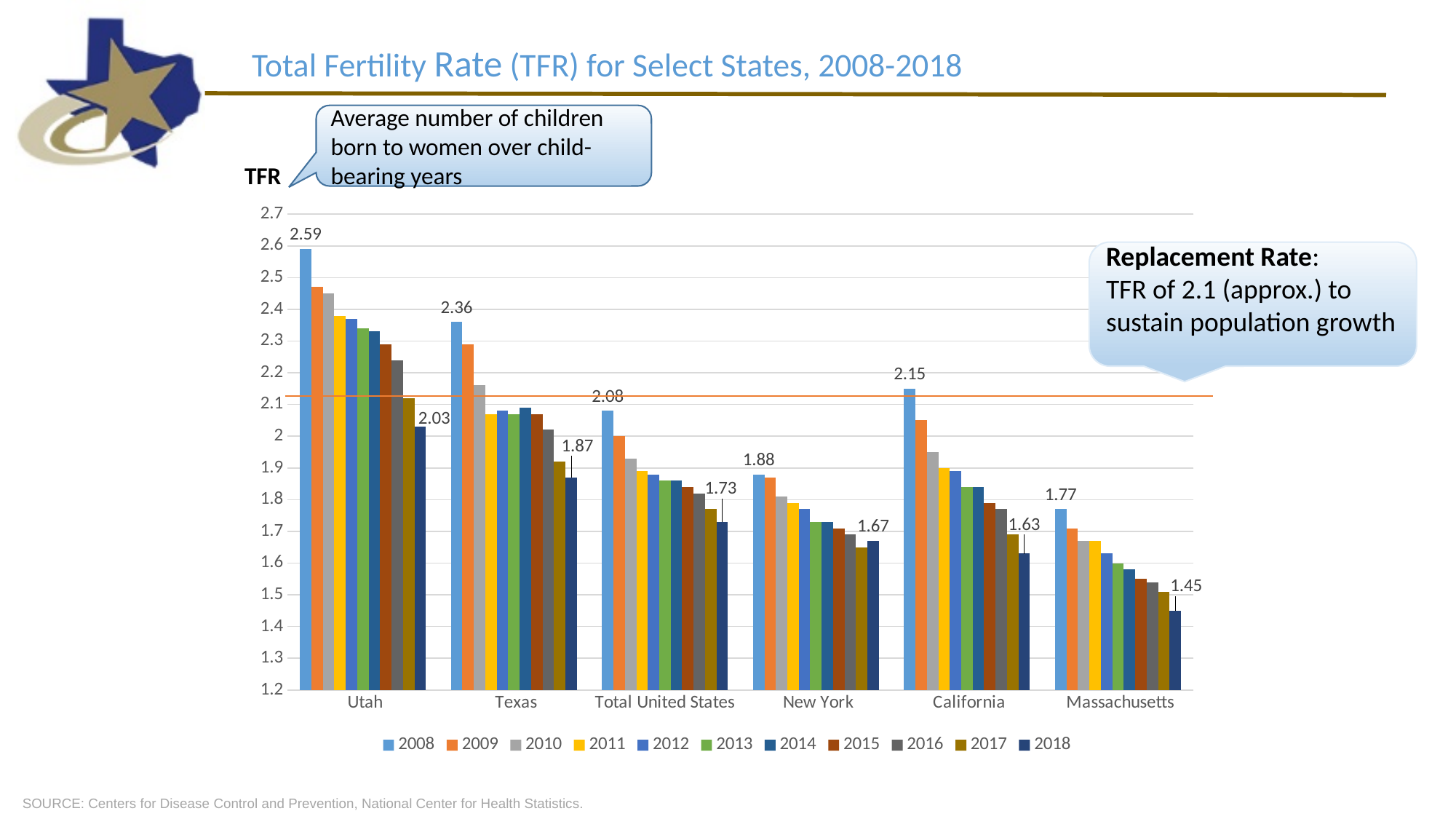
What was Texas's total fertility rate in 2018? 1.87 How many states or regions are shown on the x axis? 6 What was Utah's total fertility rate in 2008? 2.59 Which was higher in 2018, California's TFR or New York's TFR? New York Is the value for Texas in 2010 greater or less than 2.1? greater By how much did Utah's total fertility rate fall from 2008 to 2018? 0.56 How many years (series) does the legend list? 11 What was the total fertility rate for the Total United States in 2008? 2.08 What was Massachusetts's total fertility rate in 2018? 1.45 What kind of chart is shown on the slide? Bar chart Which state had the highest total fertility rate in 2008? Utah Which state had the lowest total fertility rate in 2018? Massachusetts